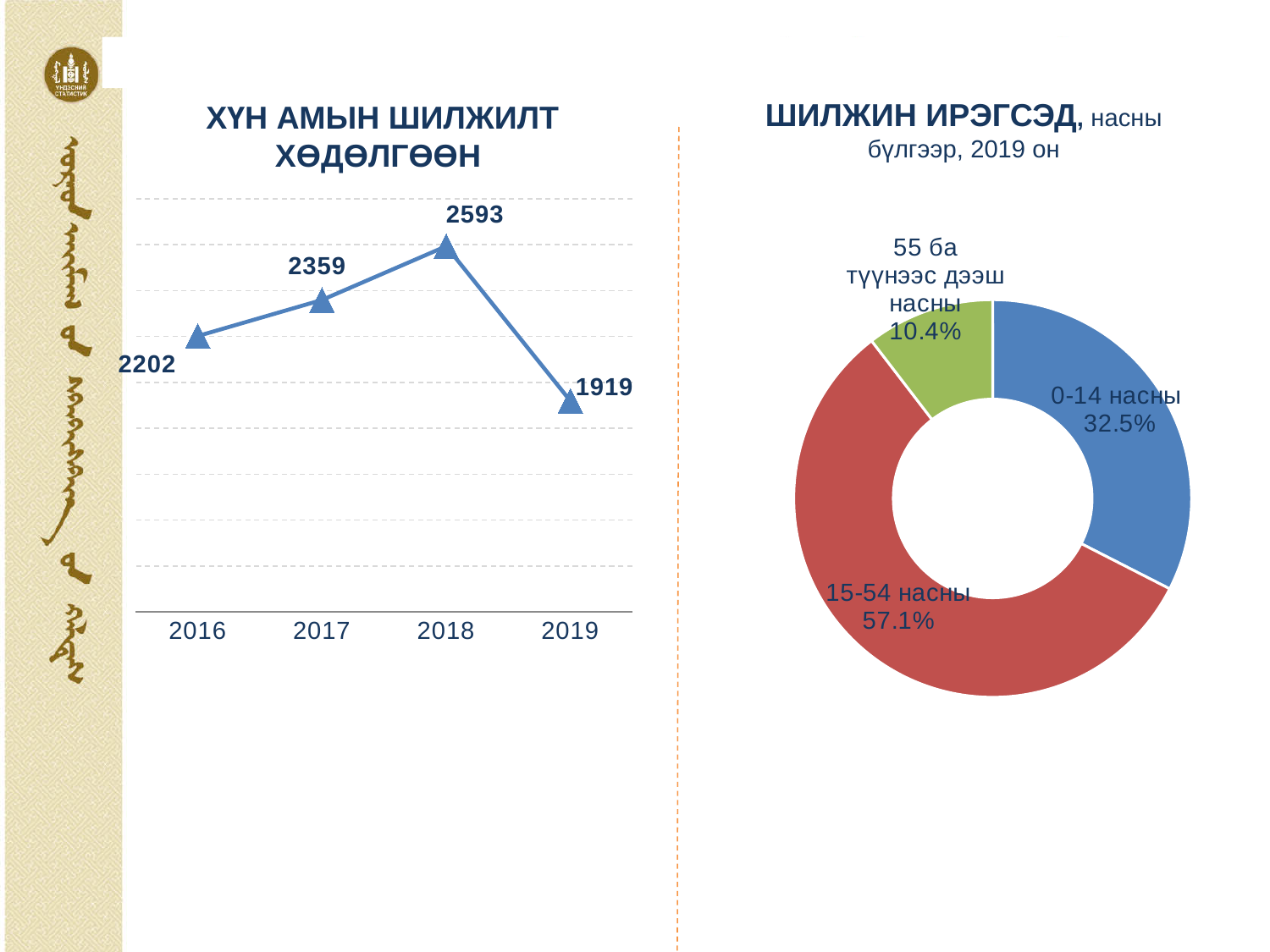
In the line chart 'ХҮН АМЫН ШИЛЖИЛТ ХӨДӨЛГӨӨН', how many years are plotted? 4 In the doughnut chart 'ШИЛЖИН ИРЭГСЭД, насны бүлгээр, 2019 он', what is the share for '15-54 насны'? 57.1% In the doughnut chart 'ШИЛЖИН ИРЭГСЭД, насны бүлгээр, 2019 он', how many age groups are shown? 3 In the line chart 'ХҮН АМЫН ШИЛЖИЛТ ХӨДӨЛГӨӨН', which is larger, the value for 2017 or the value for 2016? 2017 In the line chart 'ХҮН АМЫН ШИЛЖИЛТ ХӨДӨЛГӨӨН', which year has the highest value? 2018 What kind of chart is the chart on the left of the slide? line chart In the line chart 'ХҮН АМЫН ШИЛЖИЛТ ХӨДӨЛГӨӨН', which year has the lowest value? 2019 In the line chart 'ХҮН АМЫН ШИЛЖИЛТ ХӨДӨЛГӨӨН', what is the value for 2016? 2202 In the doughnut chart 'ШИЛЖИН ИРЭГСЭД, насны бүлгээр, 2019 он', which age group has the smallest share? 55 ба түүнээс дээш насны In the line chart 'ХҮН АМЫН ШИЛЖИЛТ ХӨДӨЛГӨӨН', does the value rise or fall from 2018 to 2019? fall In the line chart 'ХҮН АМЫН ШИЛЖИЛТ ХӨДӨЛГӨӨН', what is the value for 2018? 2593 In the line chart 'ХҮН АМЫН ШИЛЖИЛТ ХӨДӨЛГӨӨН', what is the difference between the values for 2018 and 2019? 674